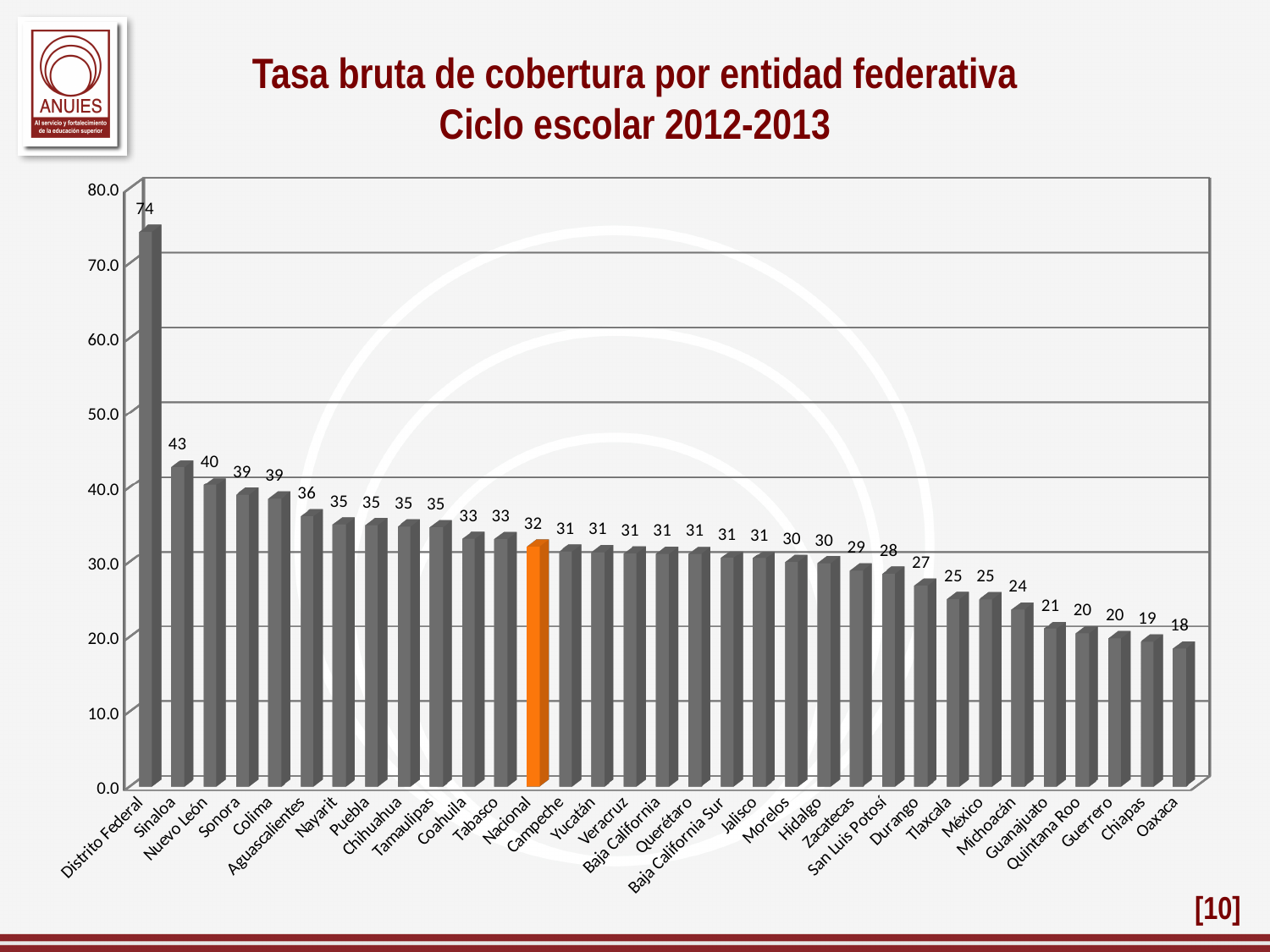
Is the value for Guanajuato greater or less than 30.0? less What is the value for Oaxaca? 18 Which entity has the highest value? Distrito Federal Which bar is highlighted in orange? Nacional How many bars are shown in the chart? 33 What is the value for Distrito Federal? 74 What is the value for Sinaloa? 43 Which entity has the lowest value? Oaxaca What is the difference between the values for Distrito Federal and Sinaloa? 31 Which has a larger value, Nuevo León or Durango? Nuevo León What is the value for the Nacional bar? 32 What kind of chart is shown on the slide? bar chart